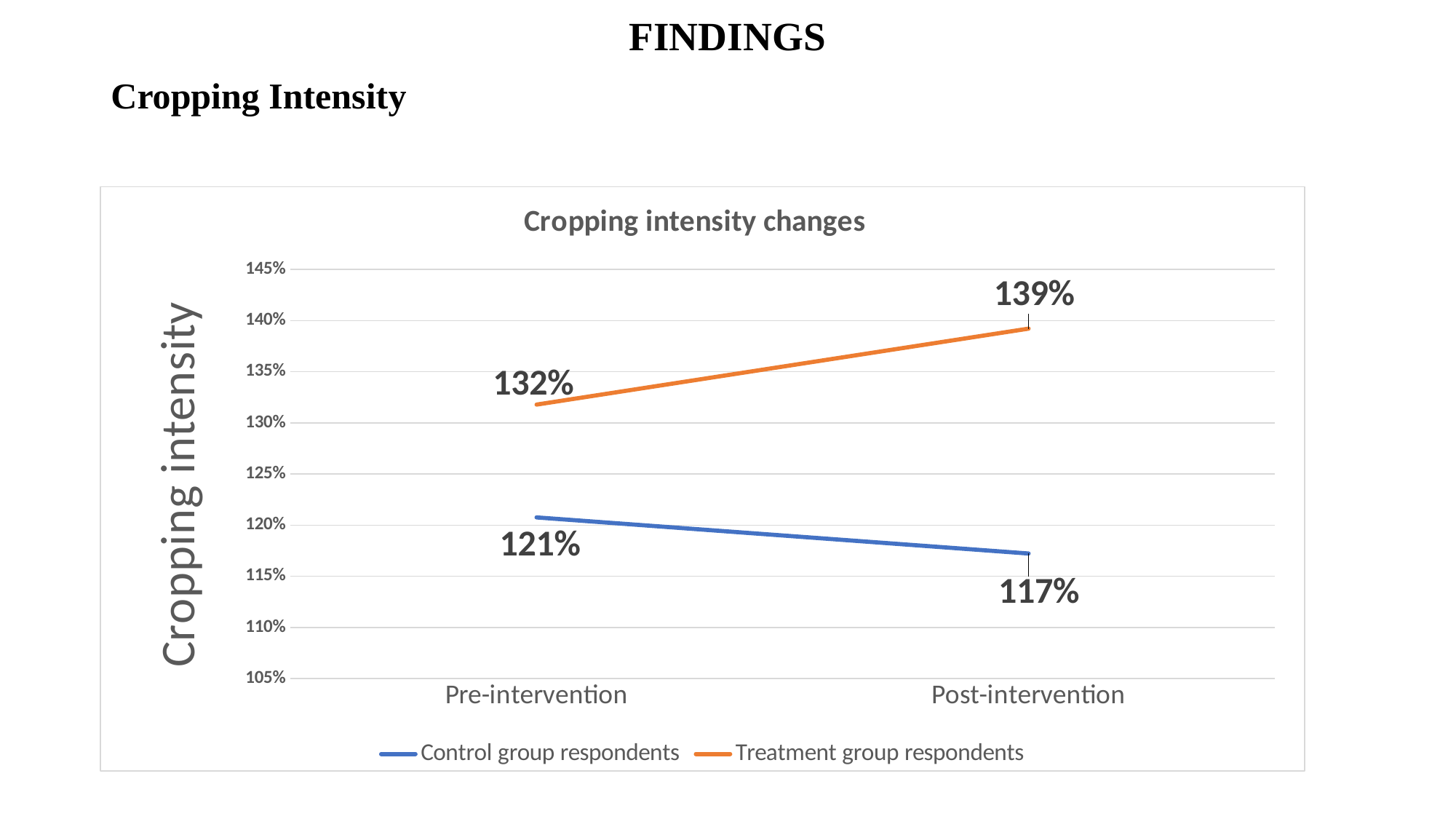
What is the cropping intensity for Control group respondents at Post-intervention? 117% What is the difference between the Treatment group and Control group values at Post-intervention? 22% Which is larger: the Control group value at Pre-intervention or at Post-intervention? Pre-intervention Which series has the lowest value at Pre-intervention? Control group respondents How many series does the legend list? 2 Which series has the highest value at Post-intervention? Treatment group respondents By how much did the Treatment group respondents' cropping intensity change from Pre-intervention to Post-intervention? 7% What is the cropping intensity for Control group respondents at Pre-intervention? 121% What is the cropping intensity for Treatment group respondents at Pre-intervention? 132% What is the cropping intensity for Treatment group respondents at Post-intervention? 139% Does the Control group respondents line rise or fall from Pre-intervention to Post-intervention? fall What type of chart is shown? line chart